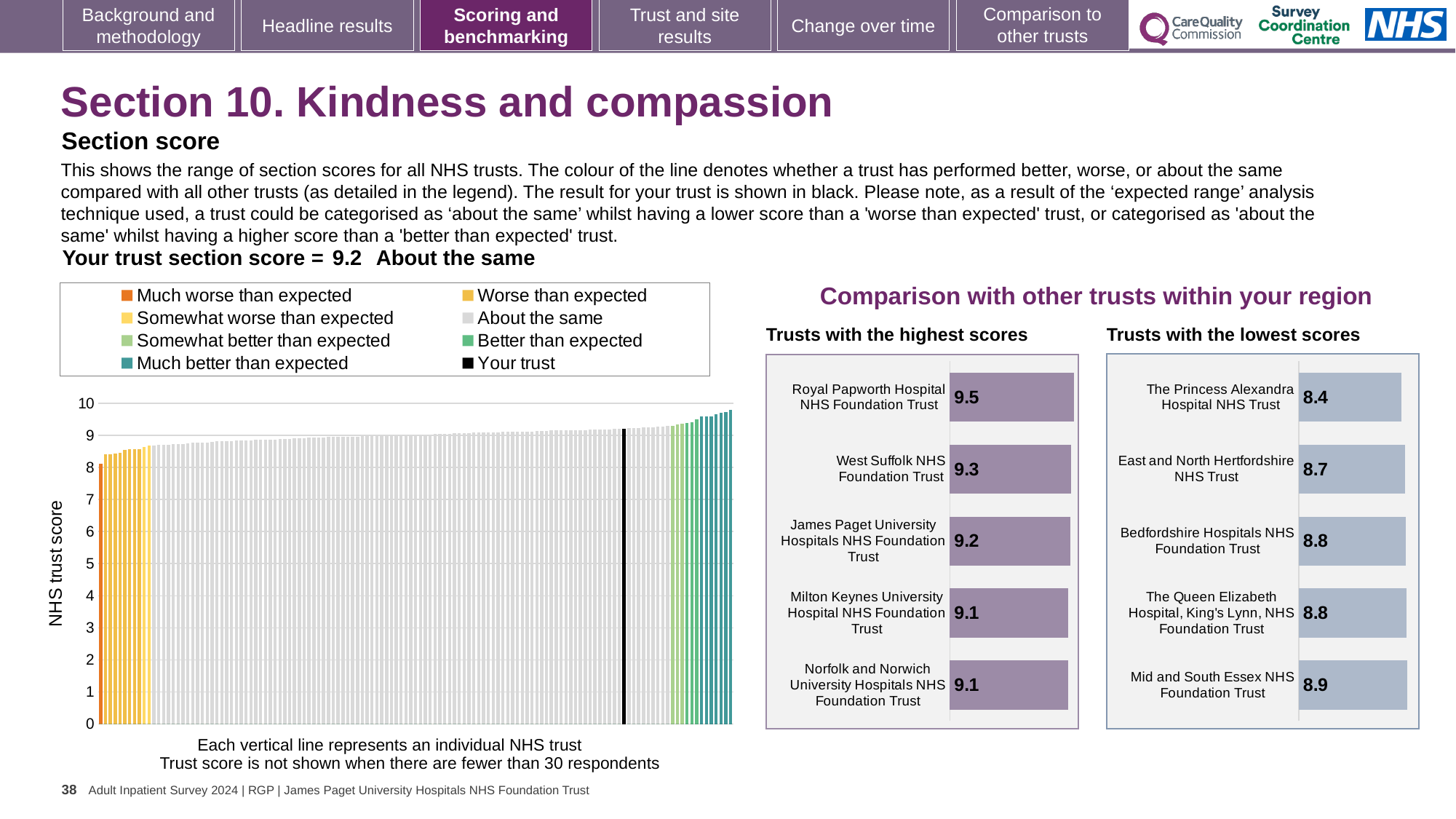
In the main chart on the left showing all NHS trusts, do the trust scores rise or fall from left to right? rise In the 'Trusts with the lowest scores' chart, what is the score for The Princess Alexandra Hospital NHS Trust? 8.4 In the 'Trusts with the lowest scores' chart, what is the score for Mid and South Essex NHS Foundation Trust? 8.9 In the main chart on the left showing all NHS trusts, what is the section score for your trust (the black line)? 9.2 In the 'Trusts with the highest scores' chart, what is the score for Royal Papworth Hospital NHS Foundation Trust? 9.5 In the 'Trusts with the highest scores' chart, which trust has the highest score? Royal Papworth Hospital NHS Foundation Trust How many trusts are listed in the 'Trusts with the highest scores' chart? 5 In the 'Trusts with the lowest scores' chart, which has the larger score: East and North Hertfordshire NHS Trust or Bedfordshire Hospitals NHS Foundation Trust? Bedfordshire Hospitals NHS Foundation Trust In the 'Trusts with the highest scores' chart, what is the difference between the scores of Royal Papworth Hospital NHS Foundation Trust and Norfolk and Norwich University Hospitals NHS Foundation Trust? 0.4 In the 'Trusts with the lowest scores' chart, which trust has the lowest score? The Princess Alexandra Hospital NHS Trust In the 'Trusts with the highest scores' chart, what is the score for West Suffolk NHS Foundation Trust? 9.3 How many entries does the legend of the main chart on the left list? 8